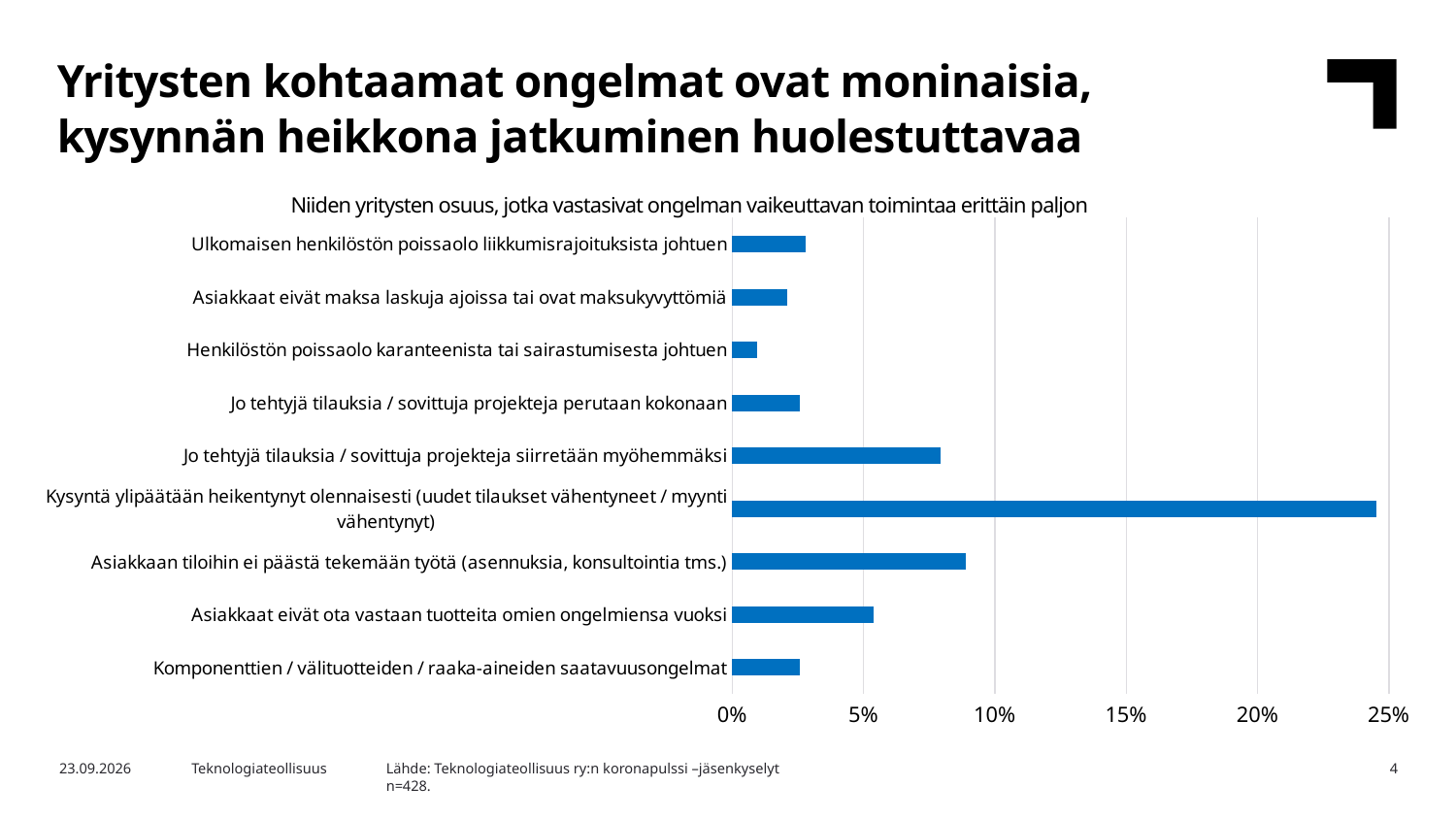
Is the value for 'Jo tehtyjä tilauksia / sovittuja projekteja siirretään myöhemmäksi' greater or less than 5%? greater Which category has the lowest value in the chart? Henkilöstön poissaolo karanteenista tai sairastumisesta johtuen Is the value for 'Asiakkaan tiloihin ei päästä tekemään työtä' greater or less than 10%? less Which is larger: the value for 'Asiakkaan tiloihin ei päästä tekemään työtä' or the value for 'Asiakkaat eivät ota vastaan tuotteita omien ongelmiensa vuoksi'? Asiakkaan tiloihin ei päästä tekemään työtä Is the value for 'Henkilöstön poissaolo karanteenista tai sairastumisesta johtuen' greater or less than 5%? less What is the maximum value shown on the chart's horizontal axis? 25% Which is larger: the value for 'Jo tehtyjä tilauksia / sovittuja projekteja siirretään myöhemmäksi' or the value for 'Jo tehtyjä tilauksia / sovittuja projekteja perutaan kokonaan'? Jo tehtyjä tilauksia / sovittuja projekteja siirretään myöhemmäksi Which category has the highest value in the chart? Kysyntä ylipäätään heikentynyt olennaisesti (uudet tilaukset vähentyneet / myynti vähentynyt) How many categories (problems) are plotted in the chart? 9 What kind of chart is shown on the slide? bar chart